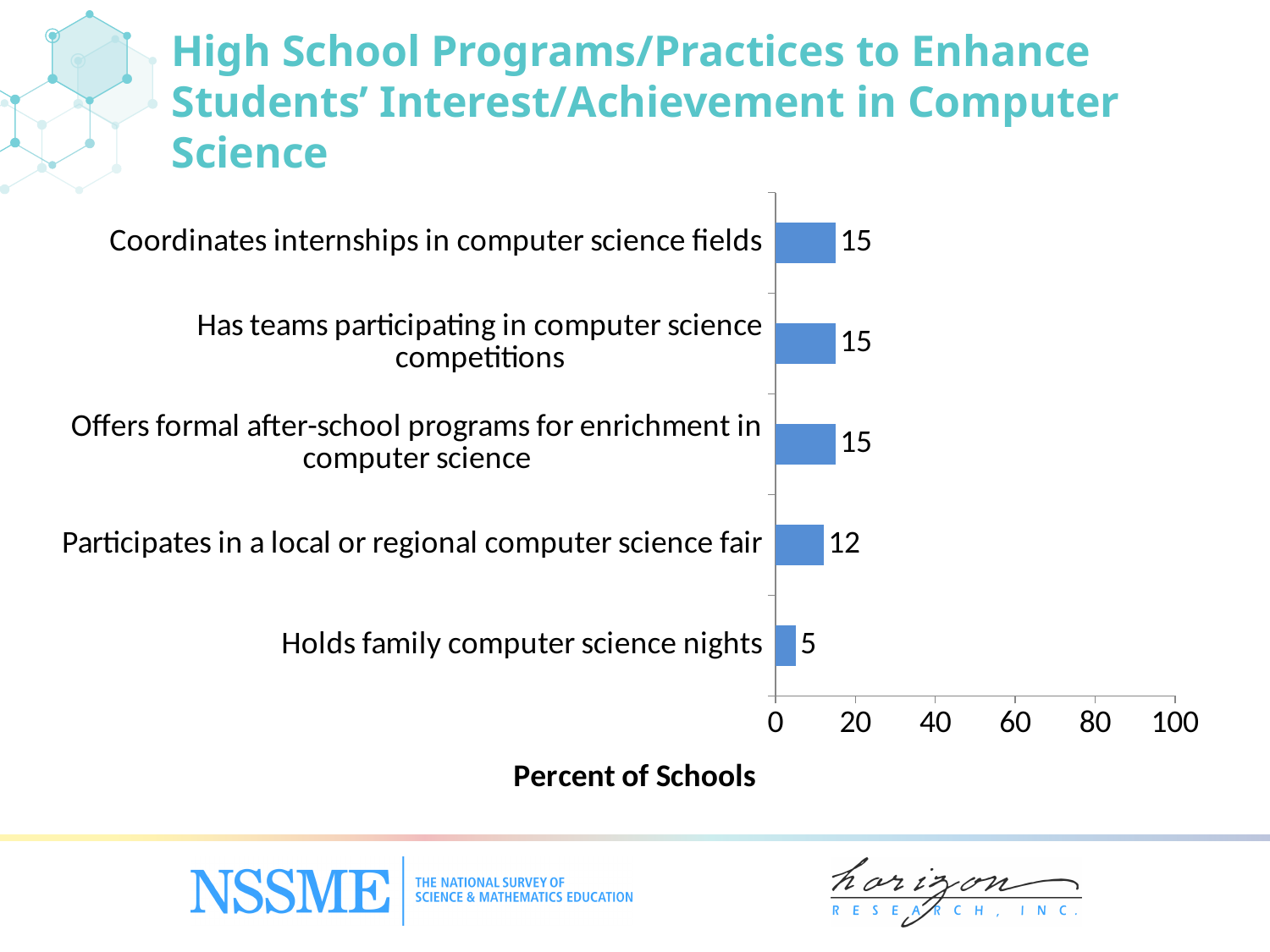
Which program/practice has the lowest percent of schools? Holds family computer science nights What percent of schools coordinate internships in computer science fields? 15 Which is larger: the percent of schools with teams participating in computer science competitions or the percent participating in a local or regional computer science fair? Has teams participating in computer science competitions What is the maximum value shown on the horizontal axis? 100 What percent of schools offer formal after-school programs for enrichment in computer science? 15 What is the label of the horizontal axis? Percent of Schools What kind of chart is shown on the slide? Bar chart Is the value for coordinating internships in computer science fields greater or less than 20? less What percent of schools participate in a local or regional computer science fair? 12 How many programs/practices are shown in the chart? 5 What is the difference in percent of schools between participating in a local or regional computer science fair and holding family computer science nights? 7 What percent of schools hold family computer science nights? 5